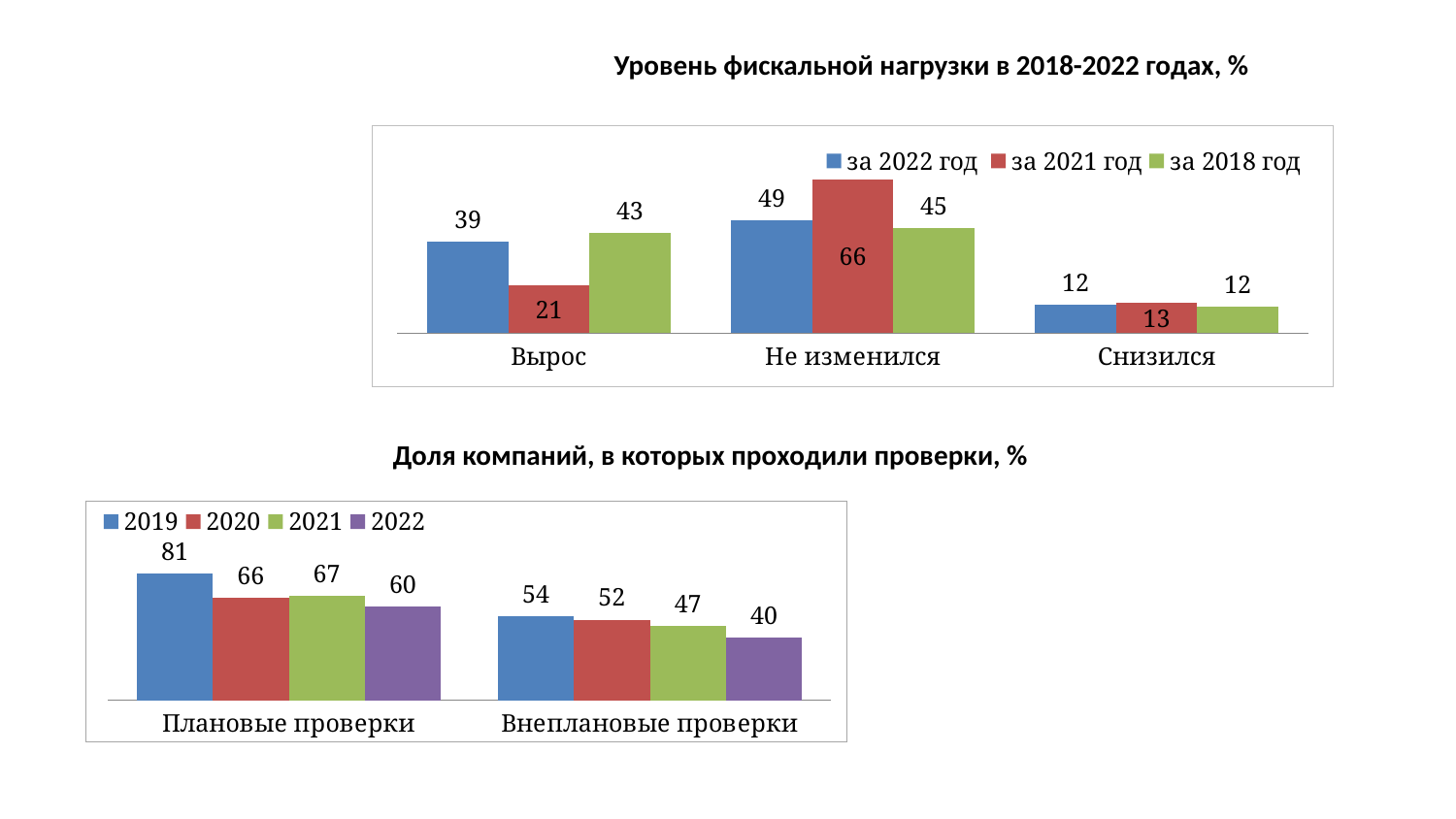
In the chart 'Доля компаний, в которых проходили проверки, %', what is the value for 'Плановые проверки' in 2019? 81 In the chart 'Уровень фискальной нагрузки в 2018-2022 годах, %', what is the value for 'Не изменился' in the series 'за 2021 год'? 66 In the chart 'Уровень фискальной нагрузки в 2018-2022 годах, %', which is larger for 'Снизился': the value for 'за 2021 год' or 'за 2018 год'? за 2021 год In the chart 'Доля компаний, в которых проходили проверки, %', what is the value for 'Внеплановые проверки' in 2022? 40 In the chart 'Уровень фискальной нагрузки в 2018-2022 годах, %', what is the value for 'Вырос' in the series 'за 2022 год'? 39 In the chart 'Уровень фискальной нагрузки в 2018-2022 годах, %', how many series does the legend list? 3 What kind of chart is 'Доля компаний, в которых проходили проверки, %'? Bar chart In the chart 'Доля компаний, в которых проходили проверки, %', what is the difference between the 2019 and 2022 values for 'Внеплановые проверки'? 14 In the chart 'Доля компаний, в которых проходили проверки, %', how many categories are shown on the x axis? 2 In the chart 'Уровень фискальной нагрузки в 2018-2022 годах, %', what is the difference between the 'за 2018 год' and 'за 2021 год' values for 'Вырос'? 22 In the chart 'Уровень фискальной нагрузки в 2018-2022 годах, %', which category has the highest value in the series 'за 2018 год'? Не изменился In the chart 'Доля компаний, в которых проходили проверки, %', which year has the lowest value for 'Плановые проверки'? 2022